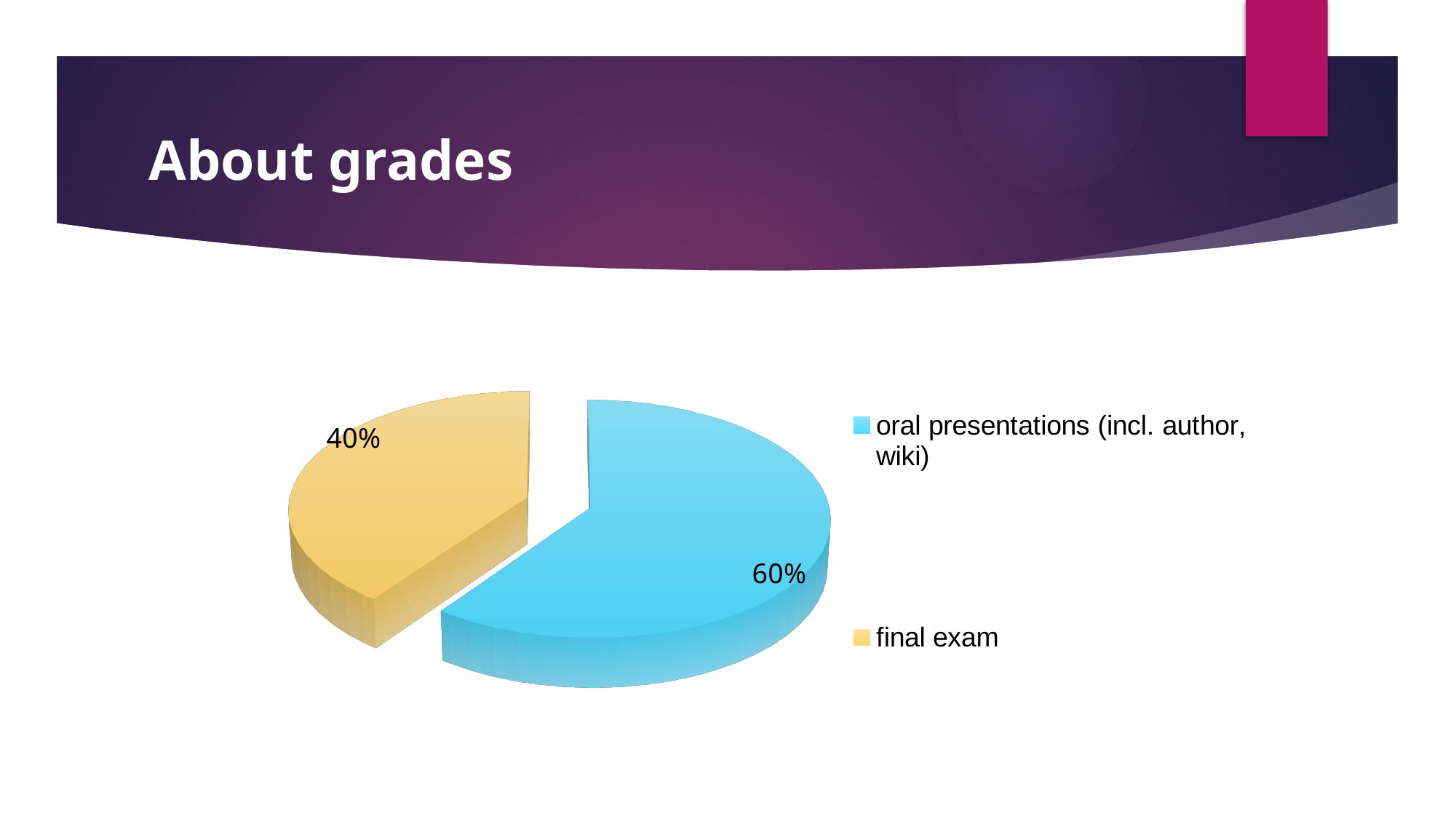
What colour is the 'final exam' slice? yellow How many entries does the legend list? 2 What share of the pie does the 'final exam' slice represent? 40% Which is larger: the 'final exam' slice or the 'oral presentations (incl. author, wiki)' slice? oral presentations (incl. author, wiki) Which slice of the pie is the smallest? final exam How many slices does the pie chart have? 2 What colour is the 'oral presentations (incl. author, wiki)' slice? blue Which slice of the pie is the largest? oral presentations (incl. author, wiki) What kind of chart is shown on the slide? pie chart What share of the pie does the 'oral presentations (incl. author, wiki)' slice represent? 60% What is the difference in percentage points between the 'oral presentations (incl. author, wiki)' slice and the 'final exam' slice? 20%